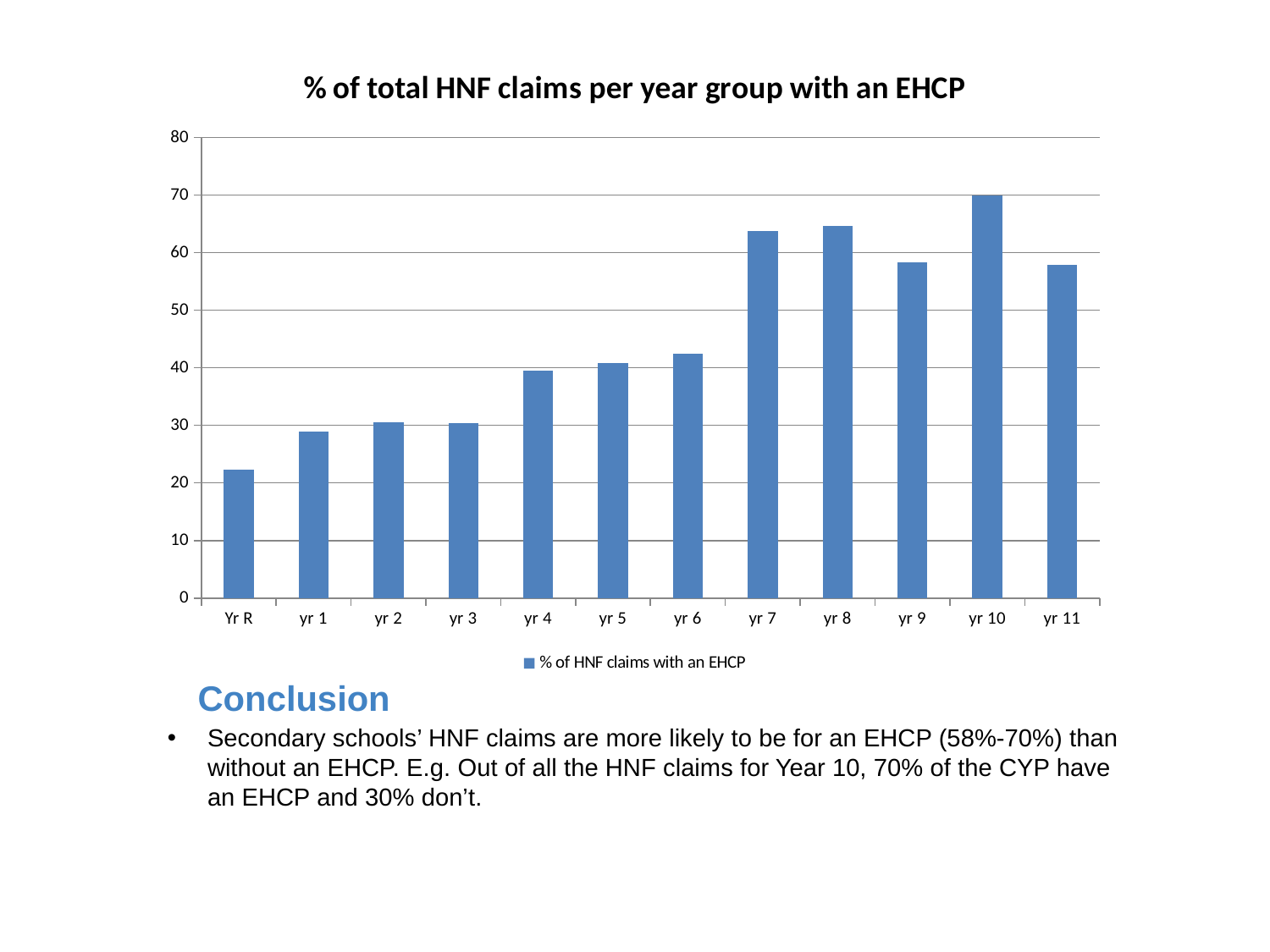
Which year group has the lowest % of HNF claims with an EHCP? Yr R What is the % of HNF claims with an EHCP for yr 10? 70 Which has a higher % of HNF claims with an EHCP, yr 6 or yr 8? yr 8 Is the value for yr 7 greater or less than 60? greater How many year groups are shown on the x axis of the chart? 12 Do the values generally rise or fall from Yr R to yr 8? rise Which year group has the highest % of HNF claims with an EHCP? yr 10 Is the value for yr 4 greater or less than 30? greater How many series does the chart legend list? 1 Is the value for Yr R greater or less than 30? less What is the title of the chart? % of total HNF claims per year group with an EHCP What kind of chart is shown on the slide? bar chart